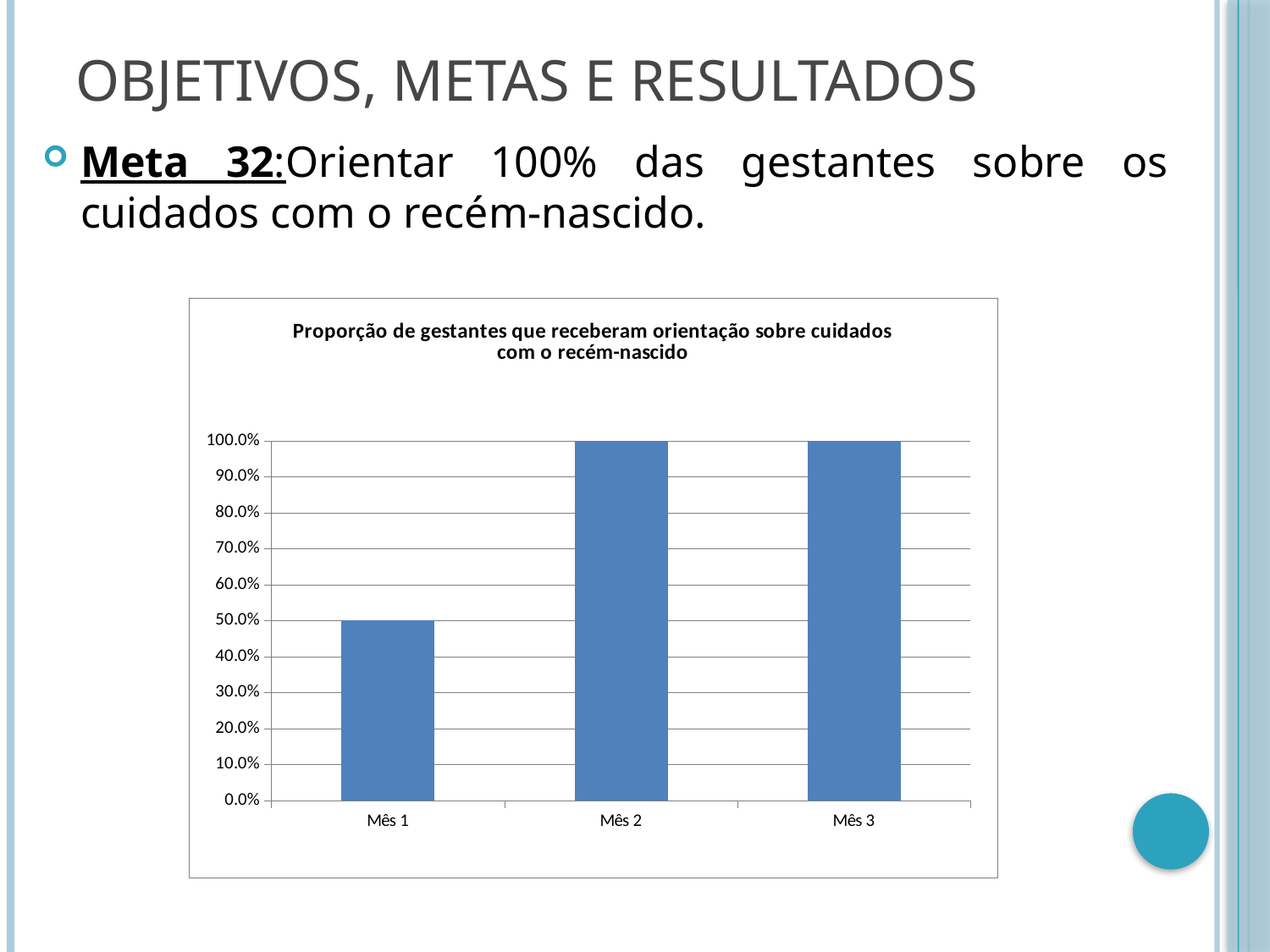
What is the value for Mês 1? 50.0% Do the values rise or fall from Mês 1 to Mês 2? Rise Is the value for Mês 3 greater or less than 90.0%? greater What is the difference between the value for Mês 2 and the value for Mês 1? 50.0% What is the value for Mês 3? 100.0% How many categories are shown on the x axis of the chart? 3 Which is larger, the value for Mês 1 or the value for Mês 2? Mês 2 Is the value for Mês 1 greater or less than 60.0%? less What is the chart's title? Proporção de gestantes que receberam orientação sobre cuidados com o recém-nascido Which month has the lowest value? Mês 1 What kind of chart is shown on the slide? Bar chart What is the value for Mês 2? 100.0%